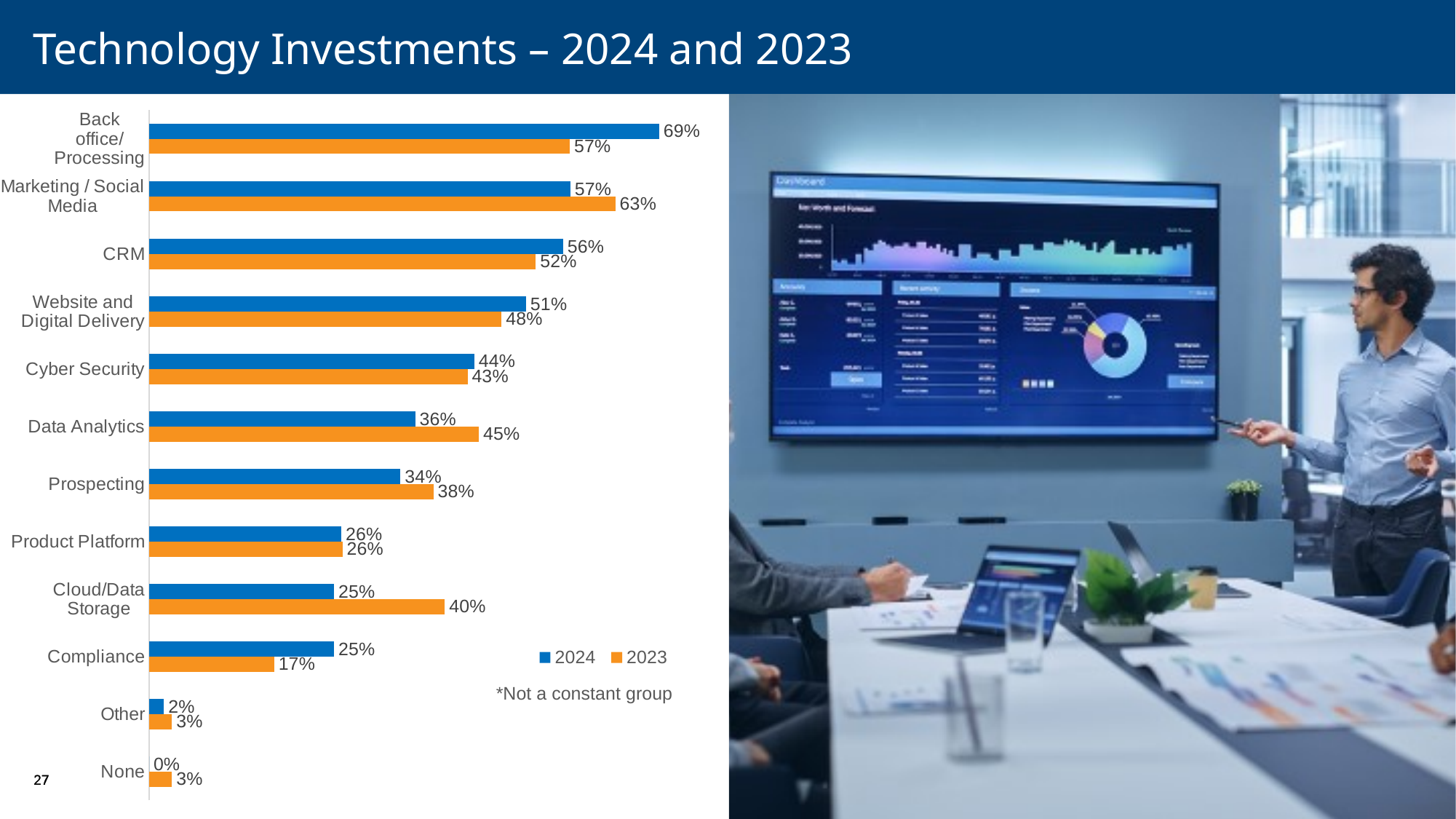
Which category had the lowest value in 2024? None What is the difference between the 2023 and 2024 values for Cloud/Data Storage? 15 percentage points What was the 2024 value for Compliance? 25% What percentage of respondents invested in Back office/Processing technology in 2024? 69% How many series does the legend list? 2 How many categories are shown in the chart? 12 What type of chart is shown on the slide? Bar chart Which category had the highest value in 2023? Marketing / Social Media Which category had the highest value in 2024? Back office/Processing What is the difference between the 2024 and 2023 values for Back office/Processing? 12 percentage points Which is larger for Data Analytics: the 2024 value or the 2023 value? 2023 What was the 2023 value for Cloud/Data Storage? 40%